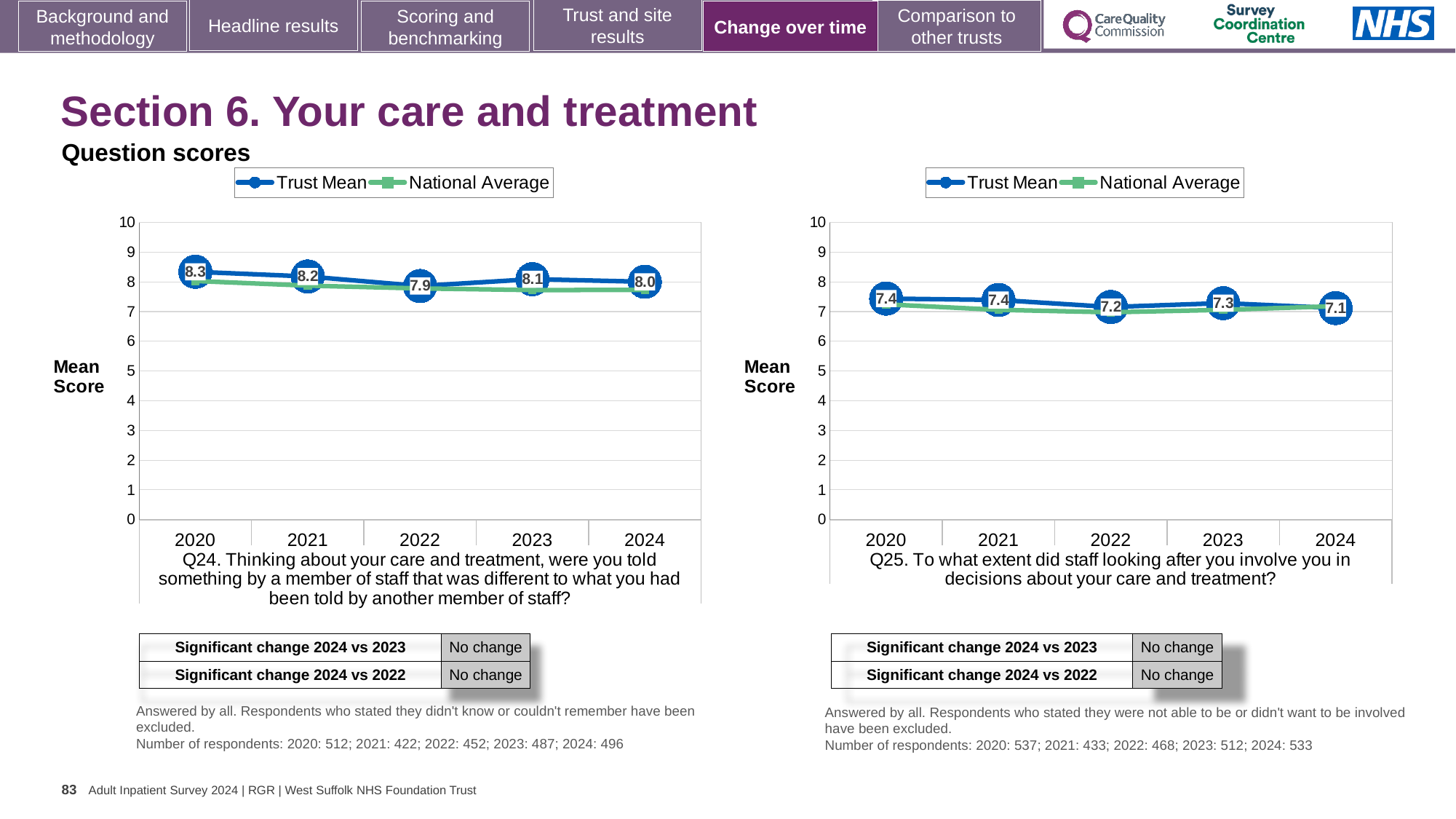
How many series does the legend of the Q25 chart on the right list? 2 In the Q24 chart on the left, what is the difference between the Trust Mean scores for 2020 and 2024? 0.3 In the Q24 chart on the left, what is the Trust Mean score for 2020? 8.3 In the Q25 chart on the right, what is the Trust Mean score for 2024? 7.1 In the Q24 chart on the left, which year has the highest Trust Mean score? 2020 In the Q25 chart on the right, which is larger, the Trust Mean score for 2021 or for 2022? 2021 How many years are shown on the x axis of the Q24 chart on the left? 5 In the Q25 chart on the right, is the National Average value for 2022 greater or less than 8? less In the Q25 chart on the right, which year has the lowest Trust Mean score? 2024 In the Q24 chart on the left, what is the Trust Mean score for 2022? 7.9 In the Q25 chart on the right, what is the Trust Mean score for 2023? 7.3 What kind of chart is the Q24 chart on the left? Line chart